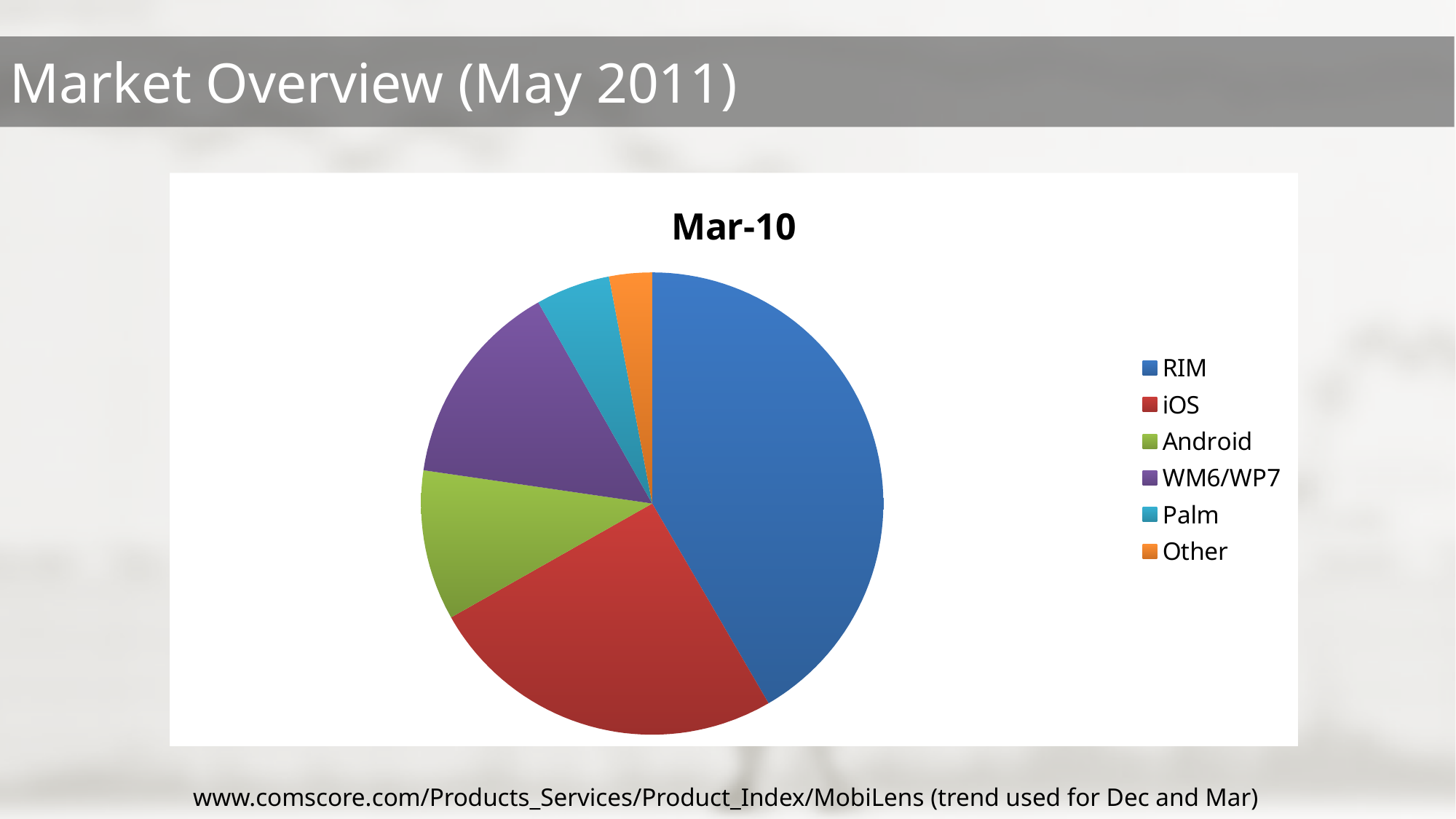
Which slice is larger, Palm or Other? Palm Which category has the second-largest slice of the pie? iOS Which slice is larger, WM6/WP7 or Android? WM6/WP7 How many slices does the pie chart have? 6 What kind of chart is shown on the slide? pie chart Which category is shown in blue in the pie chart? RIM Which slice is larger, RIM or iOS? RIM What is the title of the chart? Mar-10 Which category has the smallest slice of the pie? Other Which category has the largest slice of the pie? RIM How many entries does the legend list? 6